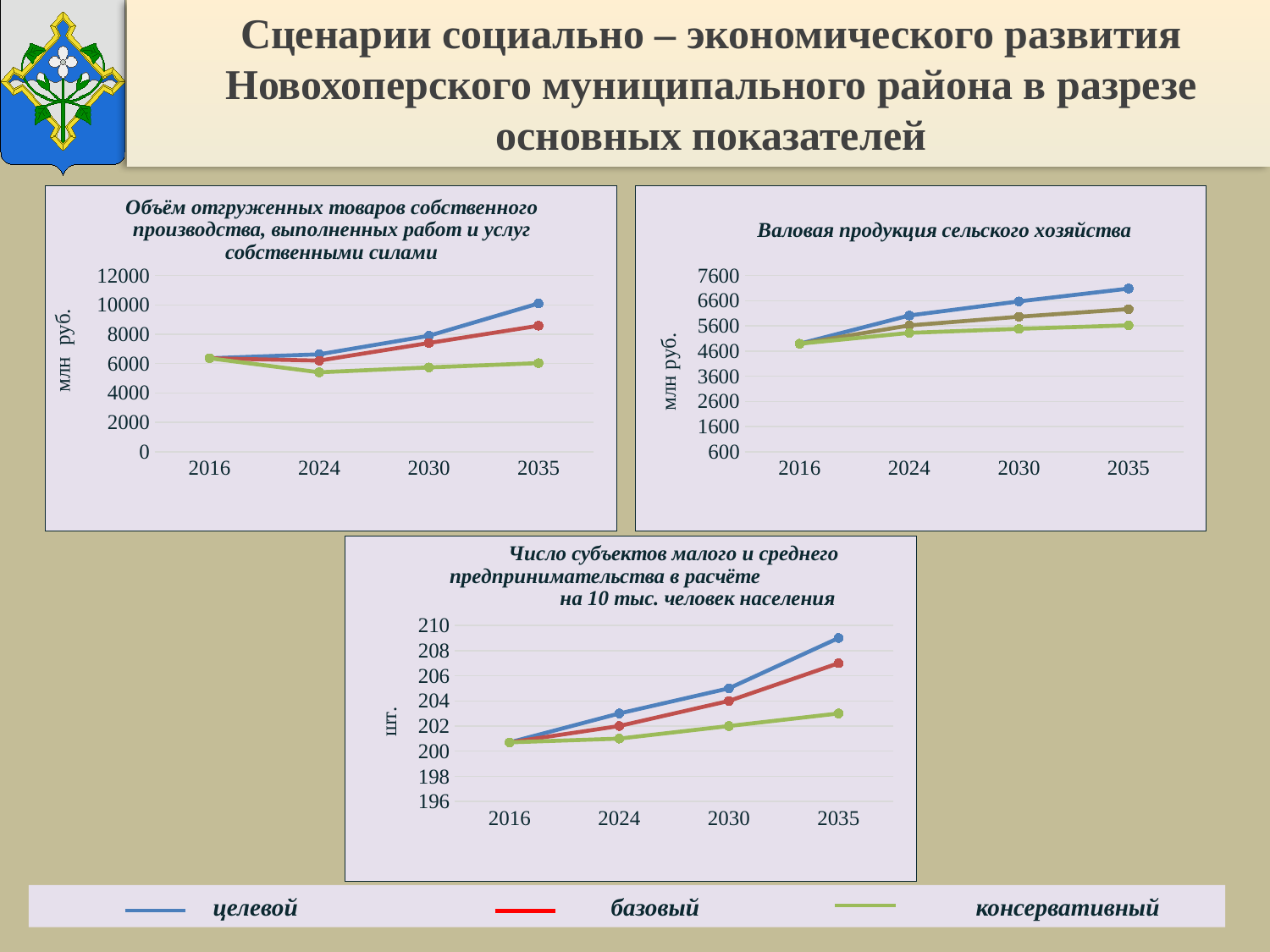
In the chart titled "Валовая продукция сельского хозяйства", is the value of the консервативный scenario in 2024 greater or less than 5600? less What kind of chart is the chart titled "Валовая продукция сельского хозяйства"? line chart In the chart titled "Число субъектов малого и среднего предпринимательства в расчёте на 10 тыс. человек населения", is the value of the целевой scenario in 2035 greater or less than 208? greater What unit is shown on the y axis of the chart titled "Число субъектов малого и среднего предпринимательства в расчёте на 10 тыс. человек населения"? шт. In the chart titled "Валовая продукция сельского хозяйства", does the целевой line rise or fall from 2016 to 2035? rises In the chart titled "Валовая продукция сельского хозяйства", is the value of the целевой scenario in 2035 greater or less than 6600? greater In the chart titled "Объём отгруженных товаров собственного производства, выполненных работ и услуг собственными силами", which scenario has the lowest value in 2035? консервативный How many years are shown on the x axis of the chart titled "Число субъектов малого и среднего предпринимательства в расчёте на 10 тыс. человек населения"? 4 In the chart titled "Число субъектов малого и среднего предпринимательства в расчёте на 10 тыс. человек населения", which scenario has the highest value in 2035? целевой How many scenarios does the legend at the bottom of the slide list? 3